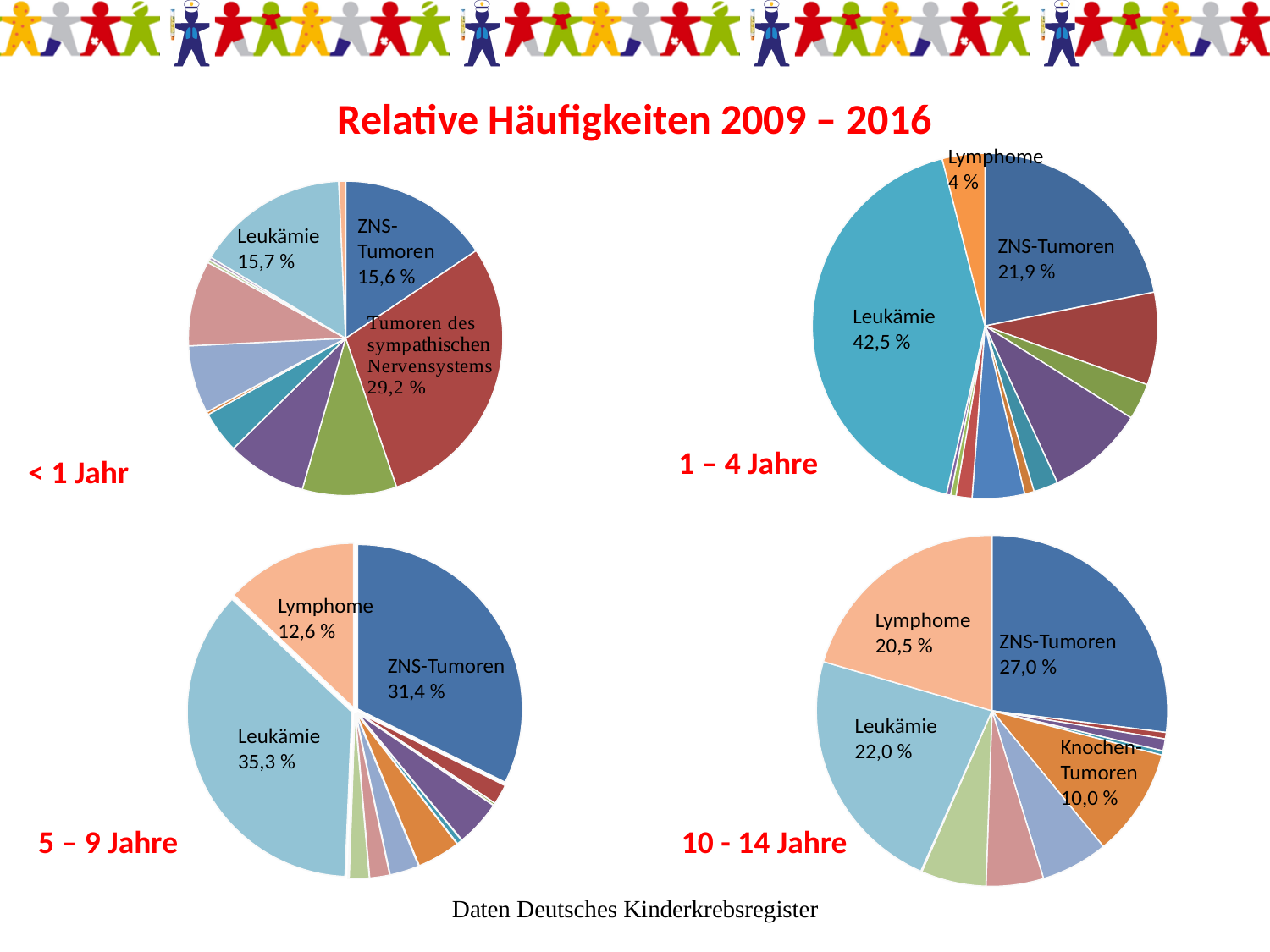
In the '10 - 14 Jahre' pie chart, what share is labelled for Knochen-Tumoren? 10,0 % What type of chart is used for each age group on this slide? Pie chart What is the title shown above the charts on this slide? Relative Häufigkeiten 2009 – 2016 In the '1 – 4 Jahre' pie chart, which labelled category has the largest slice? Leukämie In the '10 - 14 Jahre' pie chart, which labelled category has the largest slice? ZNS-Tumoren In the '< 1 Jahr' pie chart, what share is labelled for Tumoren des sympathischen Nervensystems? 29,2 % In the '1 – 4 Jahre' pie chart, how many percentage points larger is the Leukämie share than the ZNS-Tumoren share? 20,6 % In the '5 – 9 Jahre' pie chart, what share is labelled for ZNS-Tumoren? 31,4 % In the '10 - 14 Jahre' pie chart, which is larger: the share for Lymphome or the share for Leukämie? Leukämie In the '< 1 Jahr' pie chart, what share is labelled for Leukämie? 15,7 % In the '1 – 4 Jahre' pie chart, what share is labelled for Lymphome? 4 % In the '1 – 4 Jahre' pie chart, what share is labelled for Leukämie? 42,5 %